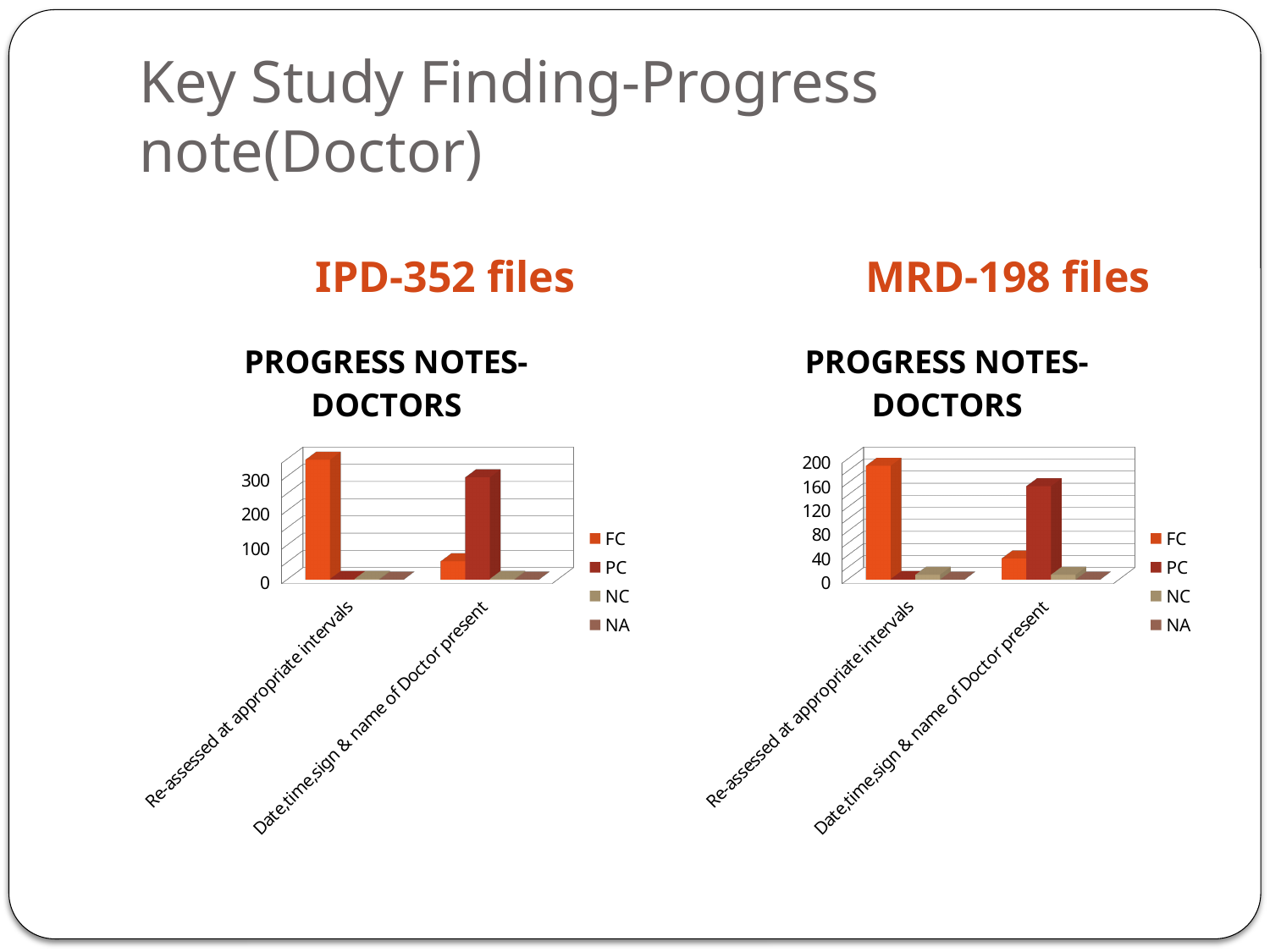
In the right chart (MRD-198 files), is the FC value for 'Re-assessed at appropriate intervals' greater or less than 160? greater In the left chart (IPD-352 files), which series has the highest value for 'Date,time,sign & name of Doctor present'? PC In the left chart (IPD-352 files), which series is larger for 'Re-assessed at appropriate intervals', FC or PC? FC What kind of chart is the left chart (IPD-352 files)? bar chart What are the legend entries of the left chart (IPD-352 files)? FC, PC, NC, NA In the left chart (IPD-352 files), is the FC value for 'Date,time,sign & name of Doctor present' greater or less than 100? less In the left chart (IPD-352 files), is the FC value for 'Re-assessed at appropriate intervals' greater or less than 300? greater In the right chart (MRD-198 files), which series is larger for 'Date,time,sign & name of Doctor present', FC or PC? PC How many categories are shown on the x axis of the left chart (IPD-352 files)? 2 How many series does the legend list on the right chart (MRD-198 files)? 4